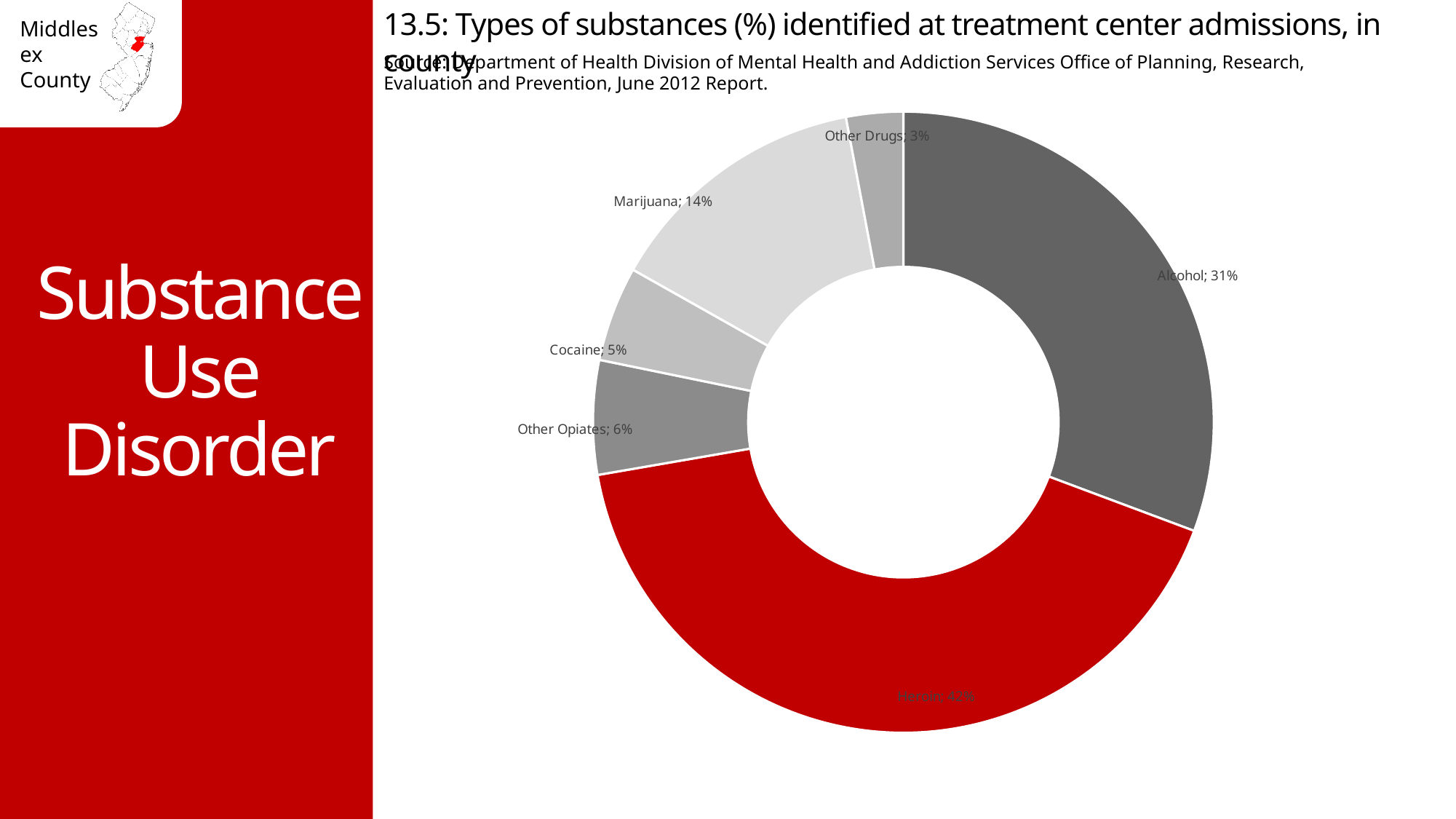
Which substance has the smallest share of admissions? Other Drugs Which substance has the largest share of admissions? Heroin Which slice of the chart is coloured red? Heroin What percentage is shown for Cocaine? 5% What percentage is shown for Other Opiates? 6% What percentage is shown for Other Drugs? 3% What kind of chart is used on this slide? doughnut chart How many substance categories are shown in the chart? 6 What percentage of treatment center admissions is attributed to Alcohol? 31% What percentage is shown for Marijuana? 14% Which has a larger share, Other Opiates or Cocaine? Other Opiates What is the difference in percentage points between Alcohol and Marijuana? 17